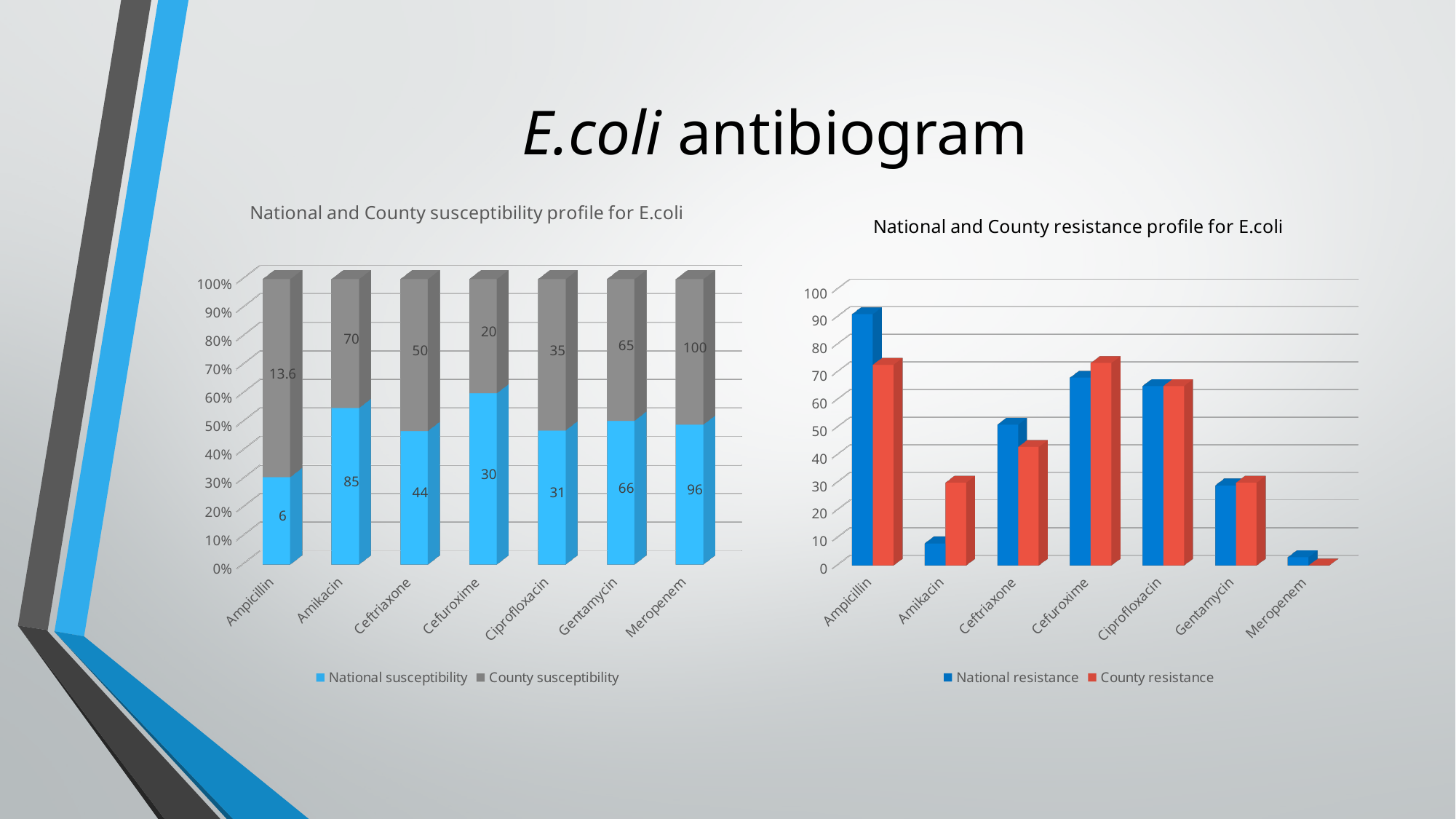
In the 'National and County susceptibility profile for E.coli' chart, which antibiotic has the highest National susceptibility value? Meropenem In the 'National and County susceptibility profile for E.coli' chart, which is larger for Ceftriaxone: National susceptibility or County susceptibility? County susceptibility In the 'National and County resistance profile for E.coli' chart, is the County resistance value for Amikacin greater or less than 20? greater What kind of chart is the 'National and County resistance profile for E.coli' chart? Bar chart In the 'National and County susceptibility profile for E.coli' chart, which antibiotic has the lowest County susceptibility value? Ampicillin In the 'National and County resistance profile for E.coli' chart, which antibiotic has the highest National resistance value? Ampicillin In the 'National and County susceptibility profile for E.coli' chart, what is the National susceptibility value for Amikacin? 85 In the 'National and County susceptibility profile for E.coli' chart, what is the difference between the National susceptibility and County susceptibility values for Amikacin? 15 In the 'National and County resistance profile for E.coli' chart, is the National resistance value for Ampicillin greater or less than 80? greater How many antibiotics are shown on the x axis of the 'National and County susceptibility profile for E.coli' chart? 7 How many series does the legend of the 'National and County resistance profile for E.coli' chart list? 2 In the 'National and County susceptibility profile for E.coli' chart, what is the County susceptibility value for Ampicillin? 13.6